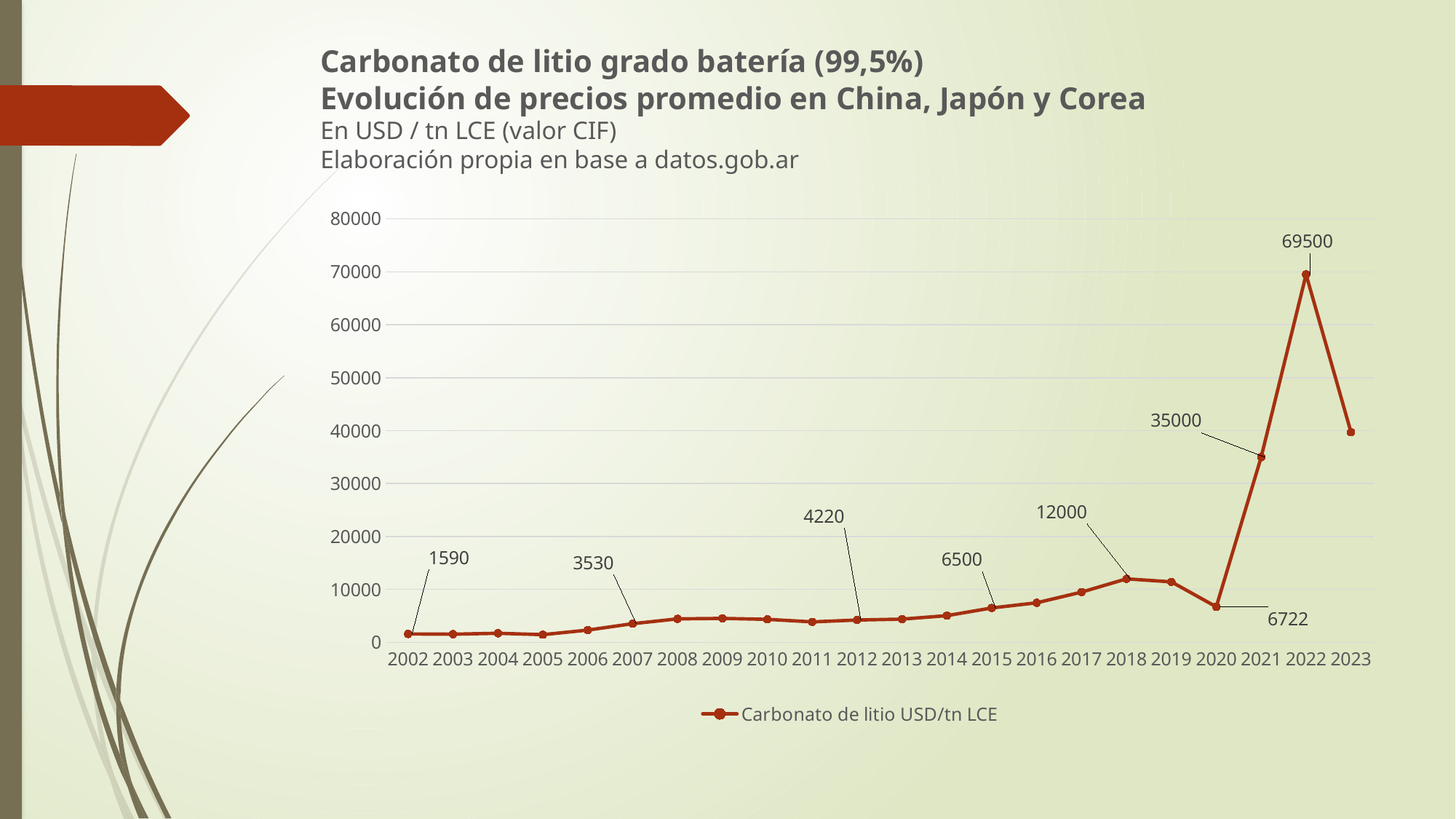
Which is larger, the value for 2015 or the value for 2018? 2018 What is the value for 2018? 12000 Is the value for 2023 greater or less than 30000? greater What series name does the legend show? Carbonato de litio USD/tn LCE What is the value for 2021? 35000 What is the difference between the values for 2022 and 2021? 34500 How many years are shown on the x axis? 22 What is the value for 2020? 6722 What is the value for 2002? 1590 What is the value for 2022? 69500 Which year has the highest value? 2022 What kind of chart is this? Line chart